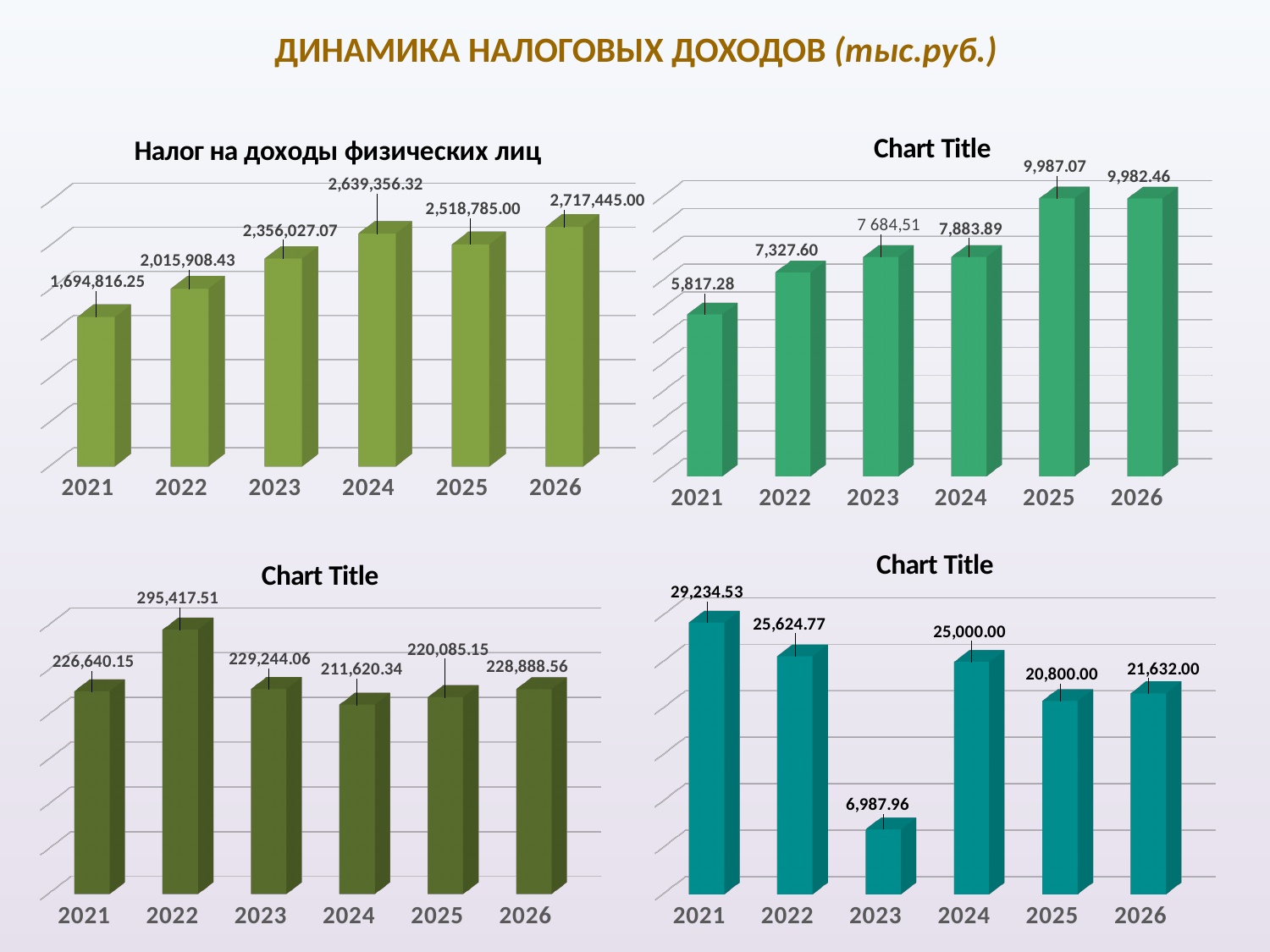
What kind of chart is the top-left chart titled 'Налог на доходы физических лиц'? Bar chart In the bottom-right chart, which year has the lowest value? 2023 How many years are shown on the x axis of the bottom-right chart? 6 In the bottom-left chart, which year has the highest value? 2022 In the top-right chart, what is the difference between the values for 2022 and 2021? 1,510.32 In the bottom-left chart, what is the value for 2024? 211,620.34 In the top-left chart titled 'Налог на доходы физических лиц', which year has the highest value? 2026 In the top-right chart, what is the value for 2025? 9,987.07 In the top-left chart titled 'Налог на доходы физических лиц', which year has the lowest value? 2021 In the top-right chart, which year has the lowest value? 2021 In the bottom-right chart, is the value for 2021 or 2022 larger? 2021 In the top-left chart titled 'Налог на доходы физических лиц', what is the value for 2023? 2,356,027.07